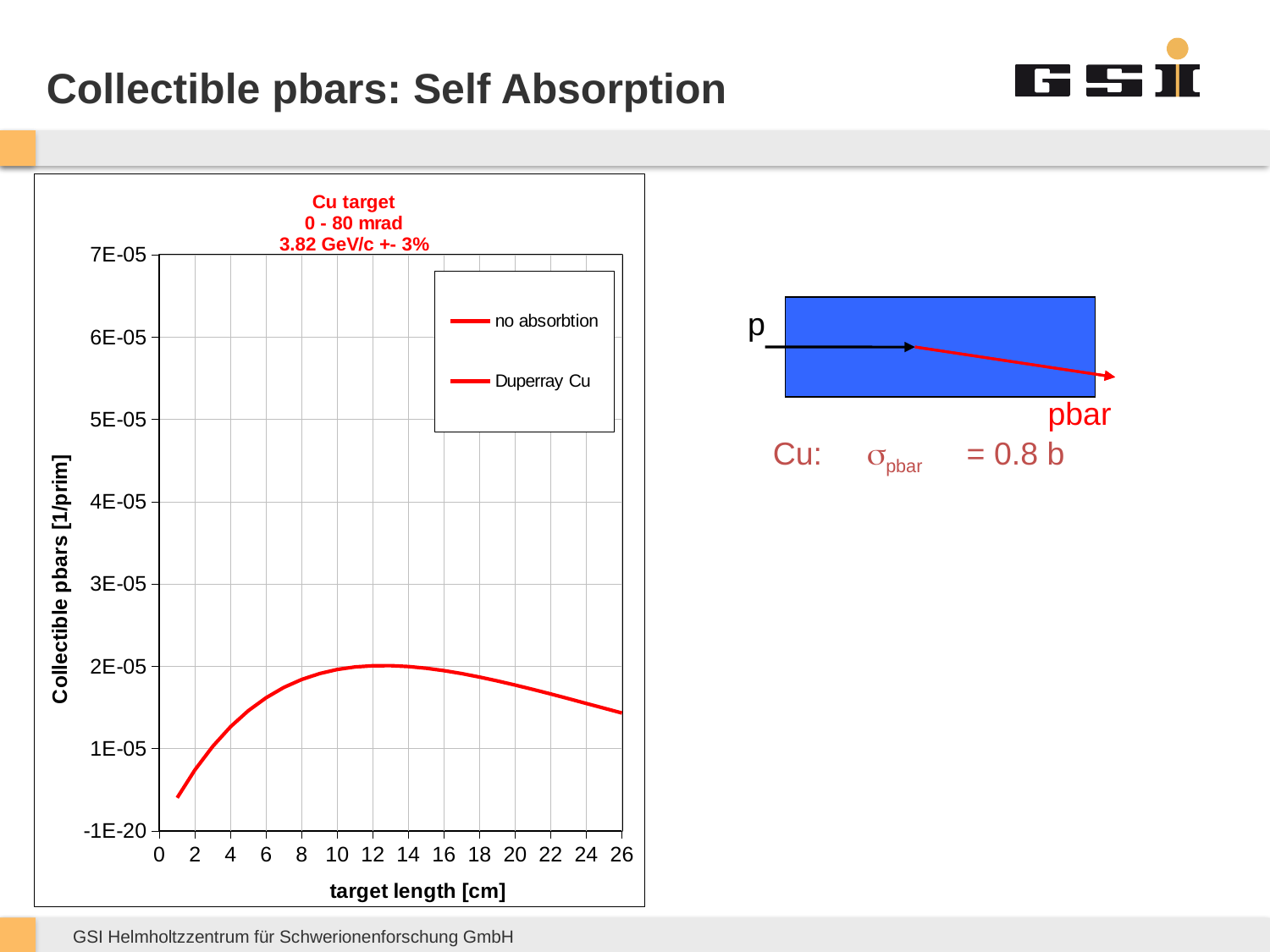
What is the title of the chart? Cu target 0 - 80 mrad 3.82 GeV/c +- 3% Is the value of the curve at a target length of 6 cm greater or less than 1E-05? greater Is the value of the curve at a target length of 20 cm greater or less than 2E-05? less Does the curve rise or fall as the target length increases from 16 to 26 cm? falls What kind of chart is shown on the slide? line chart How many tick labels are shown on the x axis of the chart? 14 Does the curve rise or fall as the target length increases from 0 to 10 cm? rises Is the value of the curve at a target length of 26 cm greater or less than 2E-05? less What is the highest value shown on the y axis of the chart? 7E-05 How many series does the chart legend list? 2 What is the label of the x axis of the chart? target length [cm]